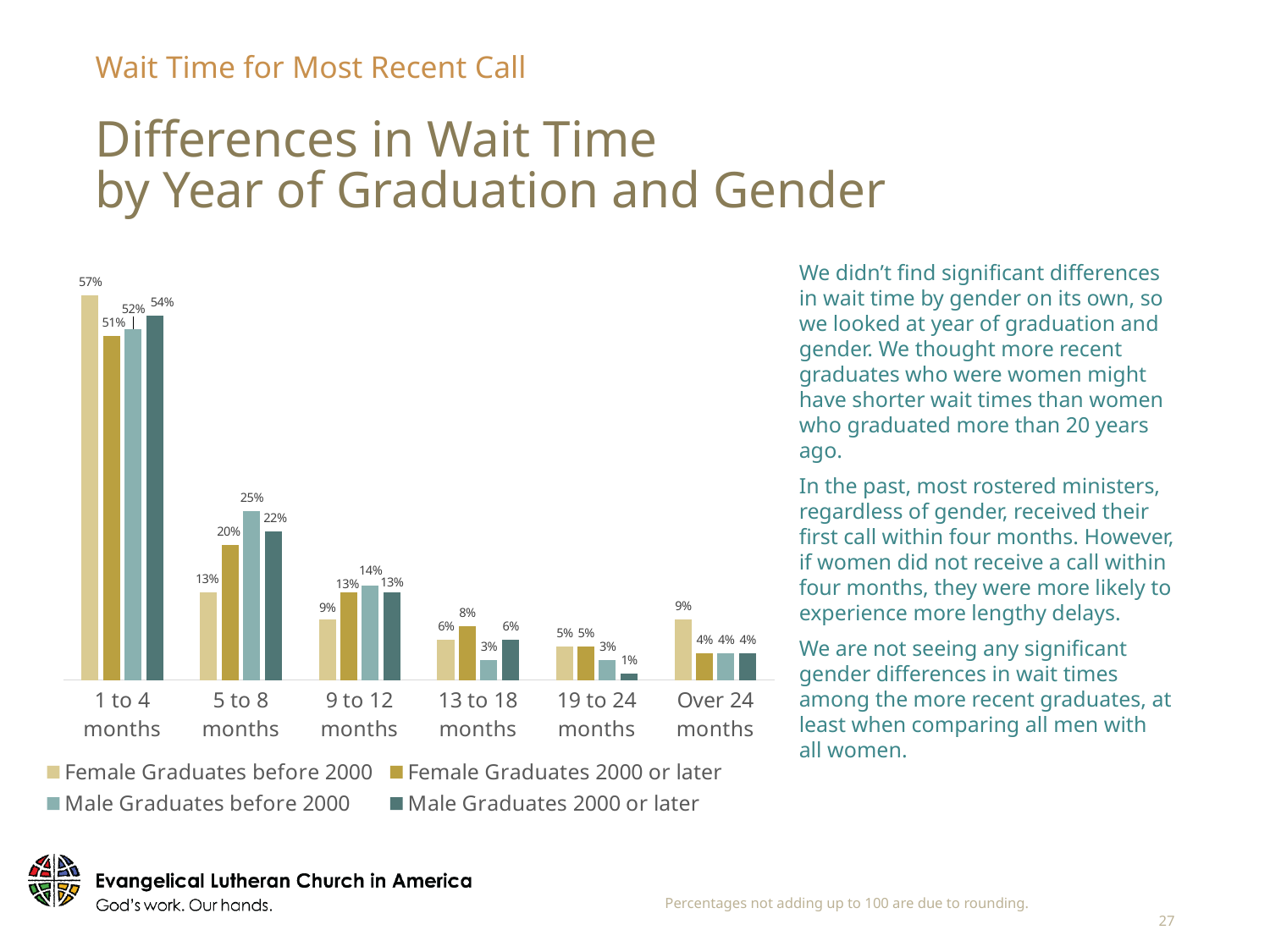
What is the difference between Male Graduates before 2000 and Female Graduates before 2000 in the 5 to 8 months category? 12% What is the value for Female Graduates before 2000 in the Over 24 months category? 9% Which series has the lowest value in the 5 to 8 months category? Female Graduates before 2000 What is the value for Male Graduates 2000 or later in the 19 to 24 months category? 1% How many wait-time categories are shown on the x axis? 6 Which series has the highest value in the 1 to 4 months category? Female Graduates before 2000 Which is larger in the 13 to 18 months category: Female Graduates 2000 or later or Male Graduates before 2000? Female Graduates 2000 or later Do the values for Female Graduates 2000 or later rise or fall from 1 to 4 months to 9 to 12 months? Fall What is the value for Male Graduates before 2000 in the 5 to 8 months category? 25% What is the value for Female Graduates before 2000 in the 1 to 4 months category? 57% How many series does the legend list? 4 What kind of chart is shown on the slide? Bar chart